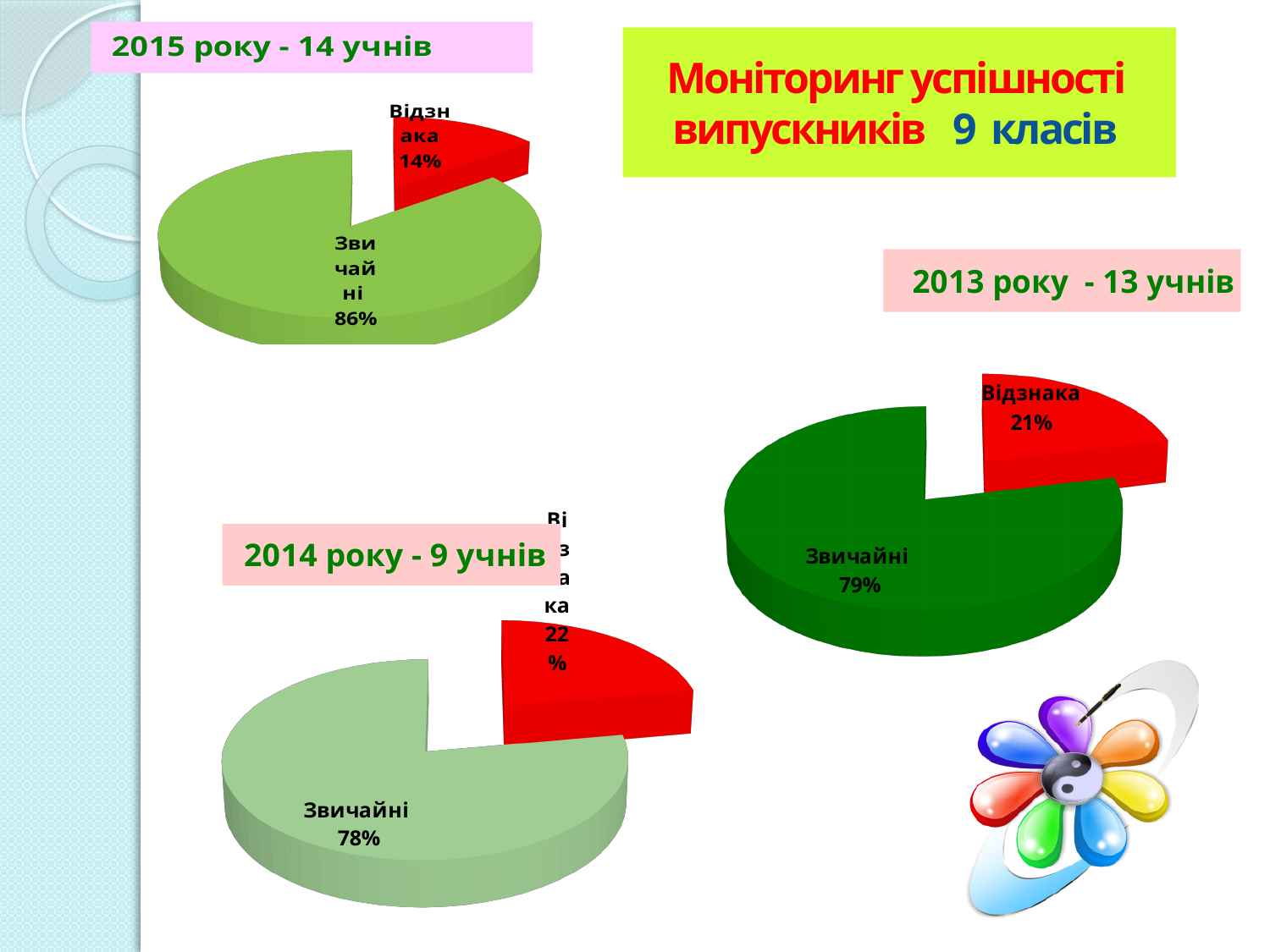
In the 2014 pie chart (2014 року - 9 учнів), what share is labelled for Відзнака? 22% In the 2015 pie chart (2015 року - 14 учнів), which slice is the smallest? Відзнака How many slices does the 2014 pie chart (2014 року - 9 учнів) have? 2 In the 2015 pie chart (2015 року - 14 учнів), what share is labelled for Звичайні? 86% In the 2014 pie chart (2014 року - 9 учнів), what share is labelled for Звичайні? 78% What kind of chart is used for the 2013 року - 13 учнів data? Pie chart How many pie charts are shown on the slide? 3 In the 2014 pie chart (2014 року - 9 учнів), what is the difference in percentage points between Звичайні and Відзнака? 56 In the 2013 pie chart (2013 року - 13 учнів), which slice is the largest? Звичайні In the 2015 pie chart (2015 року - 14 учнів), what share is labelled for Відзнака? 14% In the 2013 pie chart (2013 року - 13 учнів), what share is labelled for Звичайні? 79% In the 2013 pie chart (2013 року - 13 учнів), what share is labelled for Відзнака? 21%